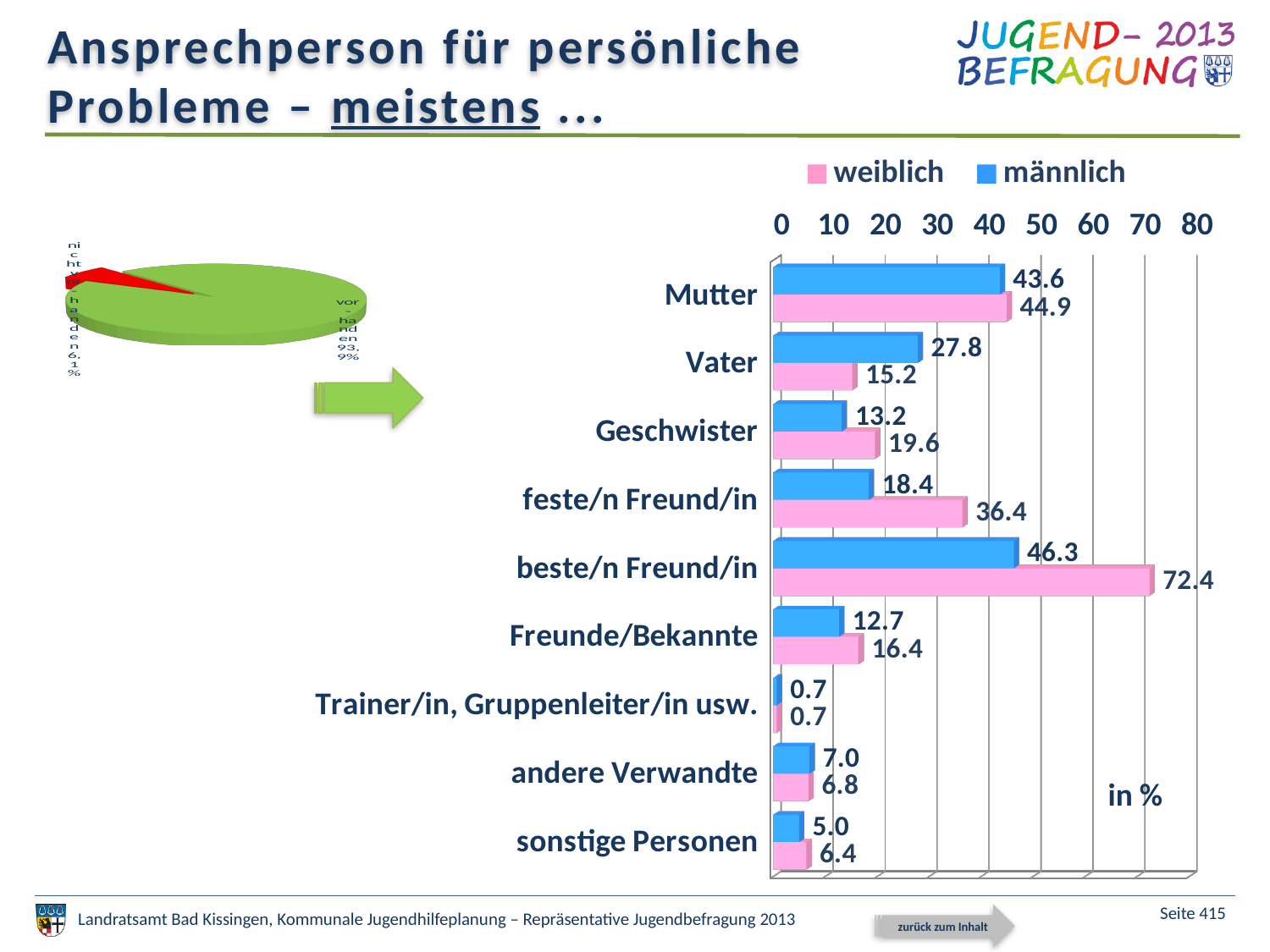
In the bar chart on the right, what is the difference between the weiblich and männlich values for beste/n Freund/in? 26.1 In the bar chart on the right, what is the value for weiblich for feste/n Freund/in? 36.4 In the pie chart on the left, what share is labelled vorhanden? 93,9% In the bar chart on the right, which category has the lowest value for weiblich? Trainer/in, Gruppenleiter/in usw. In the bar chart on the right, how many categories are shown? 9 In the bar chart on the right, which colour represents weiblich? pink In the bar chart on the right, what is the value for männlich for Vater? 27.8 In the bar chart on the right, which category has the highest value for männlich? beste/n Freund/in What kind of chart is the chart on the right? bar chart In the bar chart on the right, how many series does the legend list? 2 In the bar chart on the right, which is larger for Vater: the männlich value or the weiblich value? männlich In the bar chart on the right, what is the value for weiblich for beste/n Freund/in? 72.4